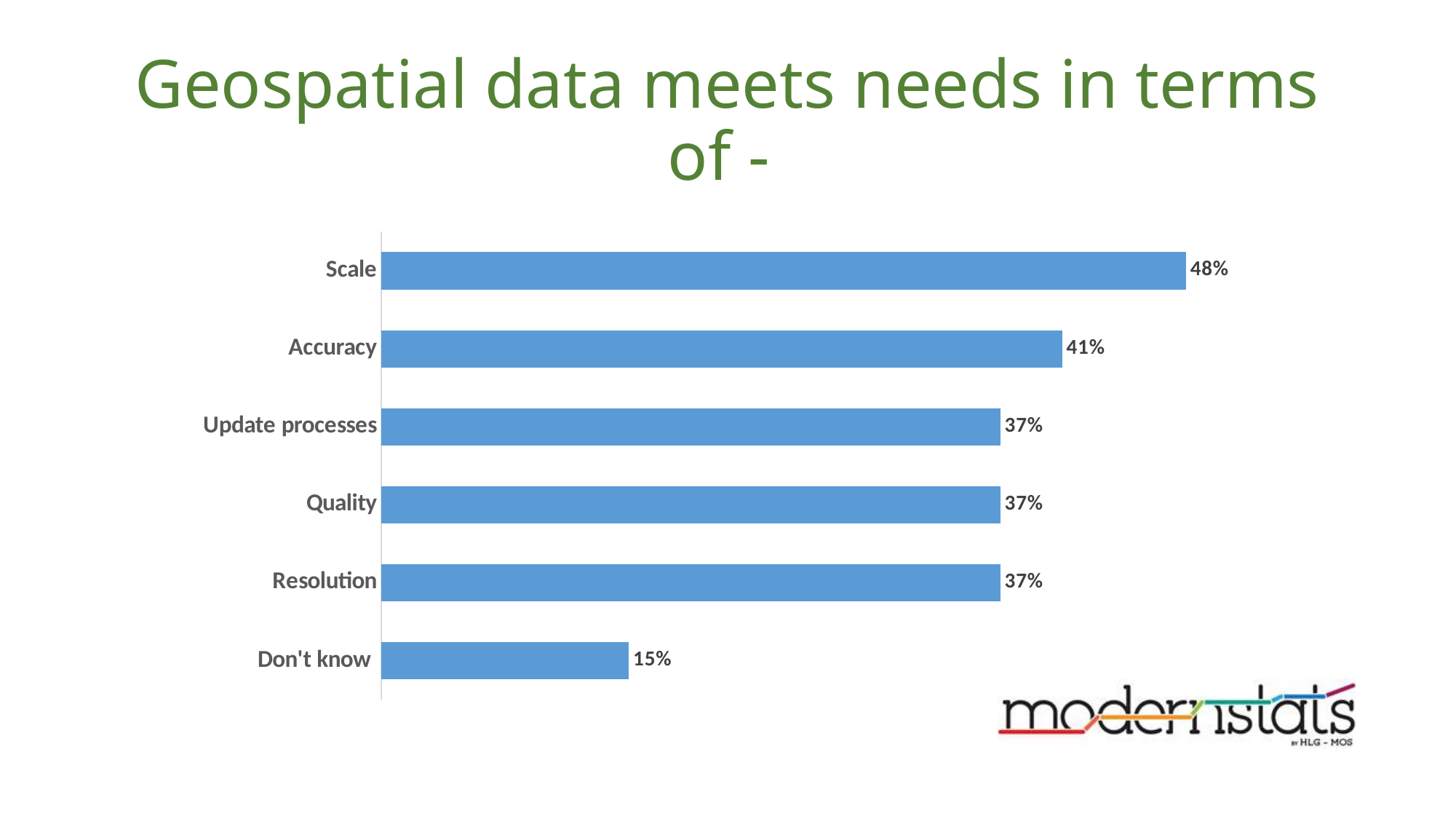
What is the value for Accuracy? 41% Which is larger, the value for Accuracy or the value for Quality? Accuracy What is the value for Don't know? 15% What is the value for Update processes? 37% Which category has the lowest value? Don't know What is the difference between the values for Scale and Accuracy? 7% How many categories are shown in the chart? 6 Which category has the highest value? Scale What is the title of the slide? Geospatial data meets needs in terms of - What kind of chart is shown on the slide? Bar chart What is the value for Scale? 48% What is the difference between the values for Resolution and Don't know? 22%